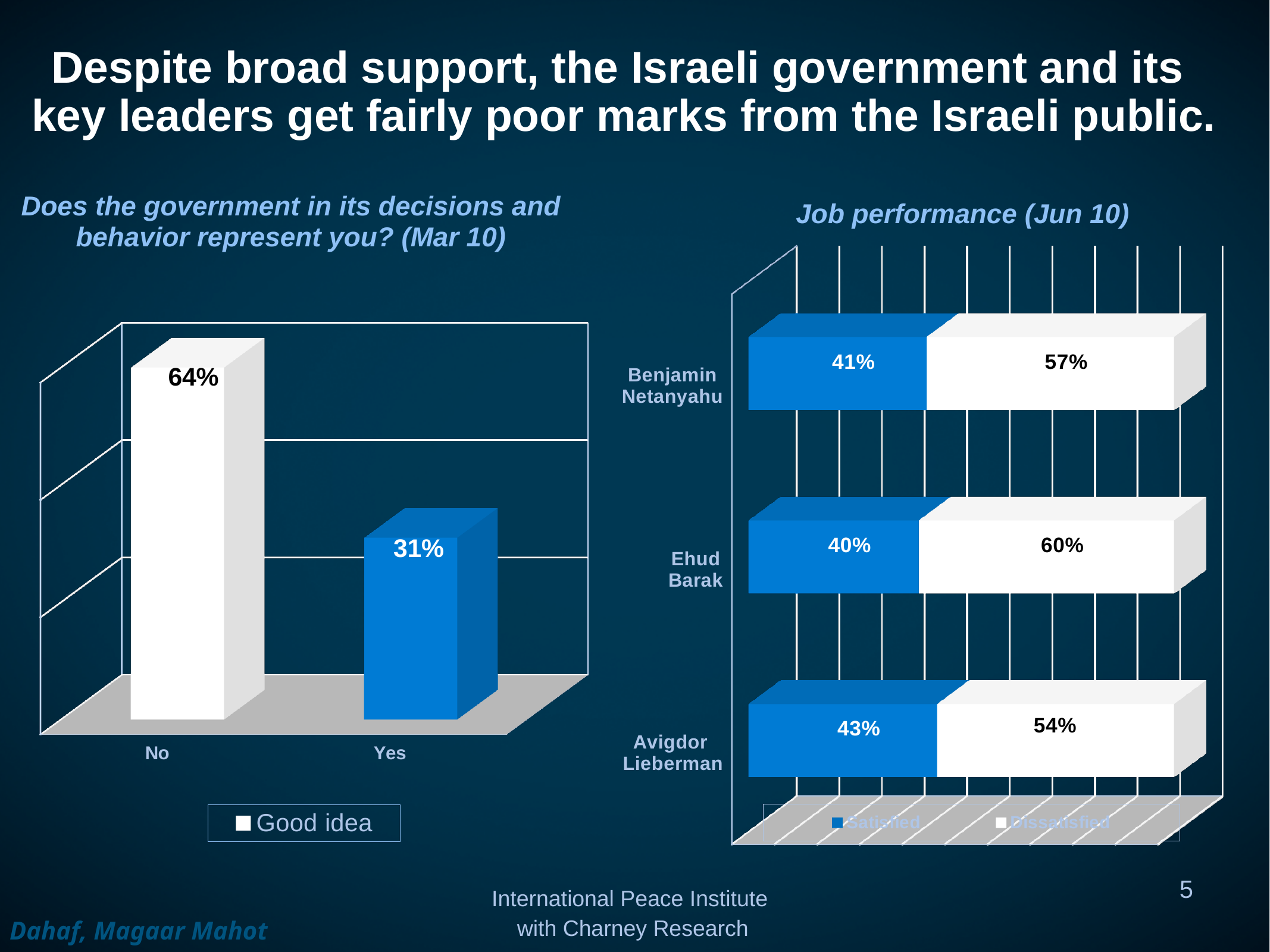
In the left chart 'Does the government in its decisions and behavior represent you? (Mar 10)', which category has the higher value? No In the right chart 'Job performance (Jun 10)', how many leaders are shown? 3 In the right chart 'Job performance (Jun 10)', what percentage is satisfied with Avigdor Lieberman? 43% In the left chart 'Does the government in its decisions and behavior represent you? (Mar 10)', what is the difference between the 'No' and 'Yes' values? 33% In the right chart 'Job performance (Jun 10)', what percentage is dissatisfied with Ehud Barak? 60% What kind of chart is the right chart 'Job performance (Jun 10)'? Stacked bar chart In the left chart 'Does the government in its decisions and behavior represent you? (Mar 10)', how many categories are shown? 2 In the right chart 'Job performance (Jun 10)', what percentage is satisfied with Benjamin Netanyahu? 41% In the right chart 'Job performance (Jun 10)', what is the difference between the dissatisfied and satisfied percentages for Benjamin Netanyahu? 16% In the left chart 'Does the government in its decisions and behavior represent you? (Mar 10)', what is the value for 'Yes'? 31% In the right chart 'Job performance (Jun 10)', which leader has the highest dissatisfied percentage? Ehud Barak In the left chart 'Does the government in its decisions and behavior represent you? (Mar 10)', what is the value for 'No'? 64%